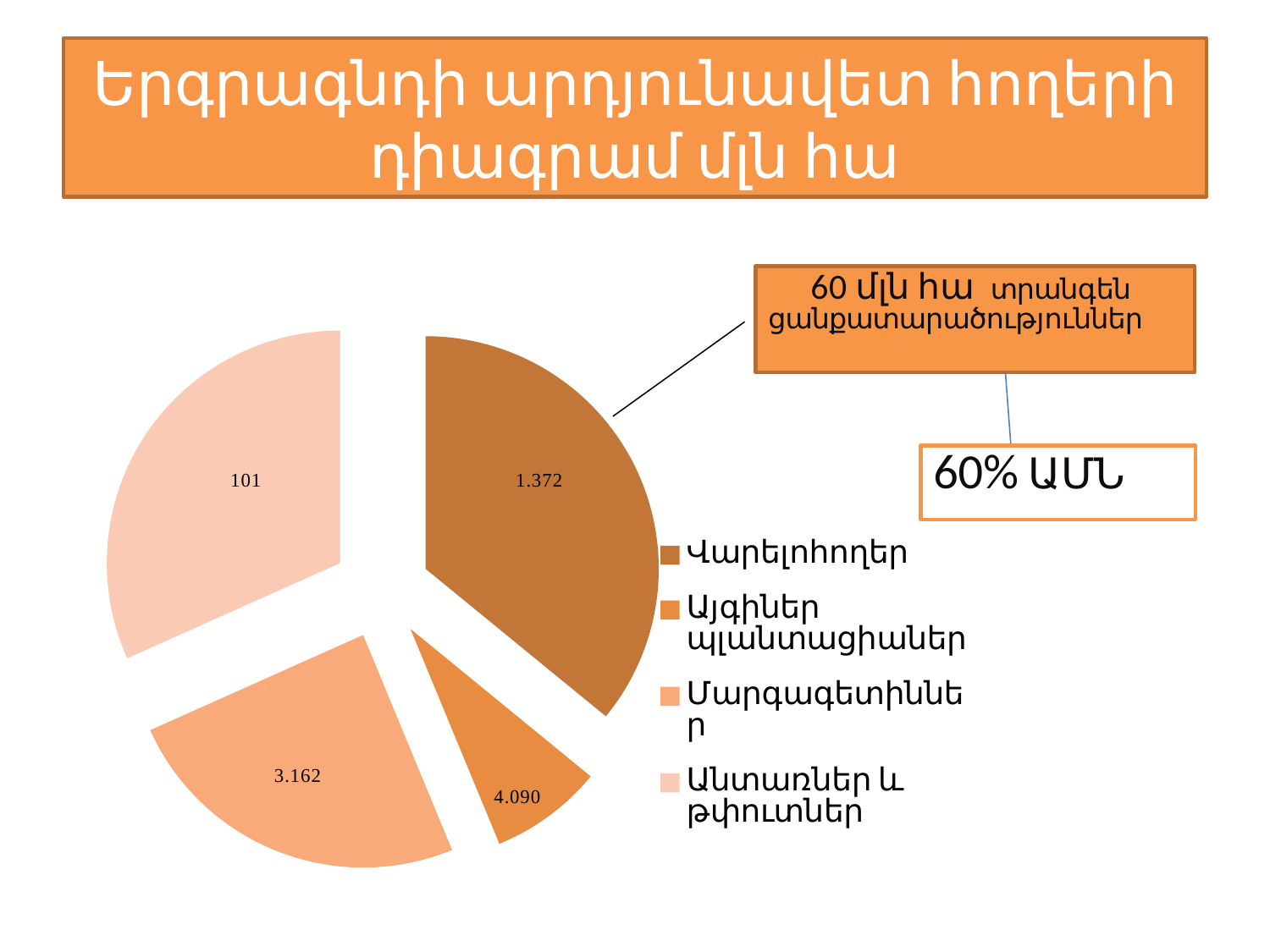
What kind of chart is shown on the slide? pie chart What is the title of the slide? Երգրագնդի արդյունավետ հողերի դիագրամ մլն հա What text is in the callout box pointing to the Վարելոհողեր slice? 60 մլն հա տրանգեն ցանքատարածություններ What is the value shown for Վարելոհողեր? 1.372 What is the value shown for Մարգագետիններ? 3.162 What is the value shown for Անտառներ և թփուտներ? 101 Which is larger, the value for Անտառներ և թփուտներ or the value for Վարելոհողեր? Վարելոհողեր What is the value shown for Այգիներ պլանտացիաներ? 4.090 How many entries does the legend list? 4 How many slices does the pie chart have? 4 Which category has the largest slice of the pie? Վարելոհողեր